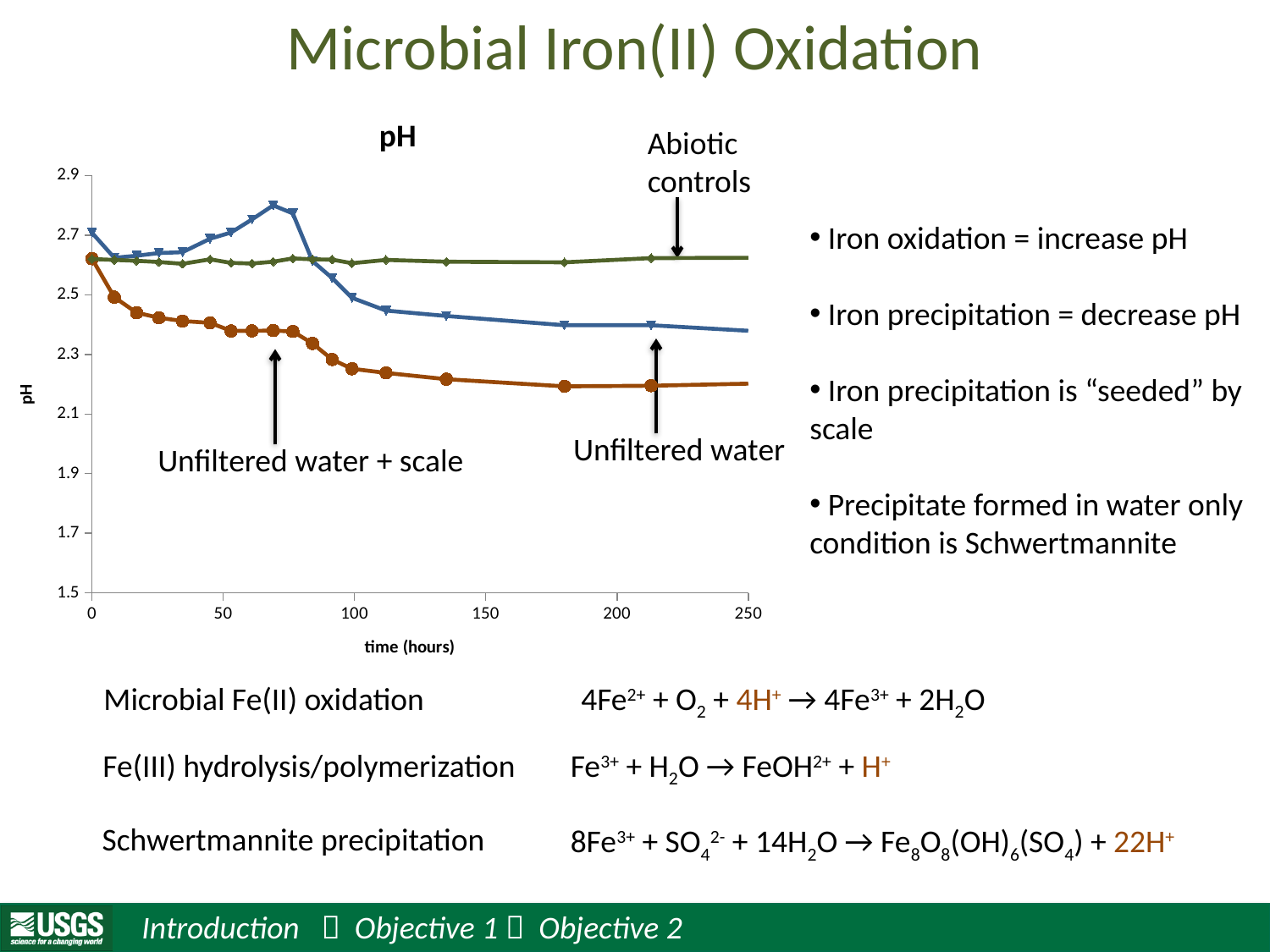
Is the pH of the Unfiltered water + scale series at 250 hours greater or less than 2.3? less How many lines (series) are plotted on the chart? 3 Which series has the highest pH at 250 hours? Abiotic controls Is the pH of the Abiotic controls series at 250 hours greater or less than 2.5? greater At 250 hours, which has the higher pH: Abiotic controls or Unfiltered water? Abiotic controls What is the title of the chart? pH Which series has the lowest pH at 250 hours? Unfiltered water + scale What is the label of the x axis of the chart? time (hours) Is the peak pH of the Unfiltered water series greater or less than 2.7? greater Does the pH of the Unfiltered water + scale series rise or fall over time? fall What kind of chart is shown on the slide? line chart